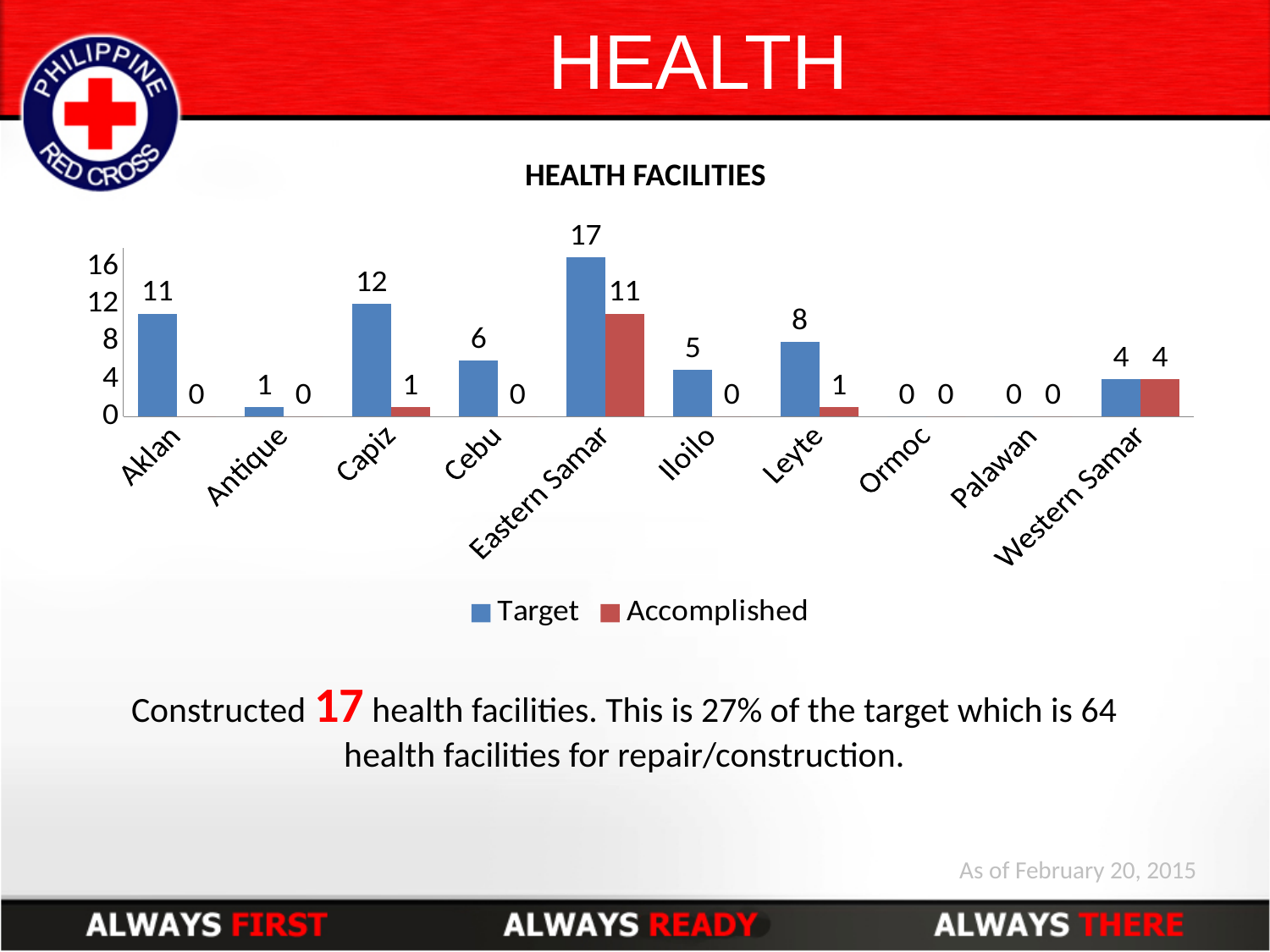
What is the Accomplished value for Eastern Samar? 11 Which category has the highest Accomplished value? Eastern Samar What is the title of the chart? HEALTH FACILITIES What is the Target value for Capiz? 12 Which is larger, the Target value for Cebu or the Target value for Iloilo? Cebu What is the Target value for Leyte? 8 What kind of chart is shown on the slide? Bar chart How many categories are shown on the x axis? 10 What is the difference between the Target and Accomplished values for Eastern Samar? 6 How many series does the legend list? 2 Which category has the highest Target value? Eastern Samar What is the difference between the Target values for Capiz and Aklan? 1